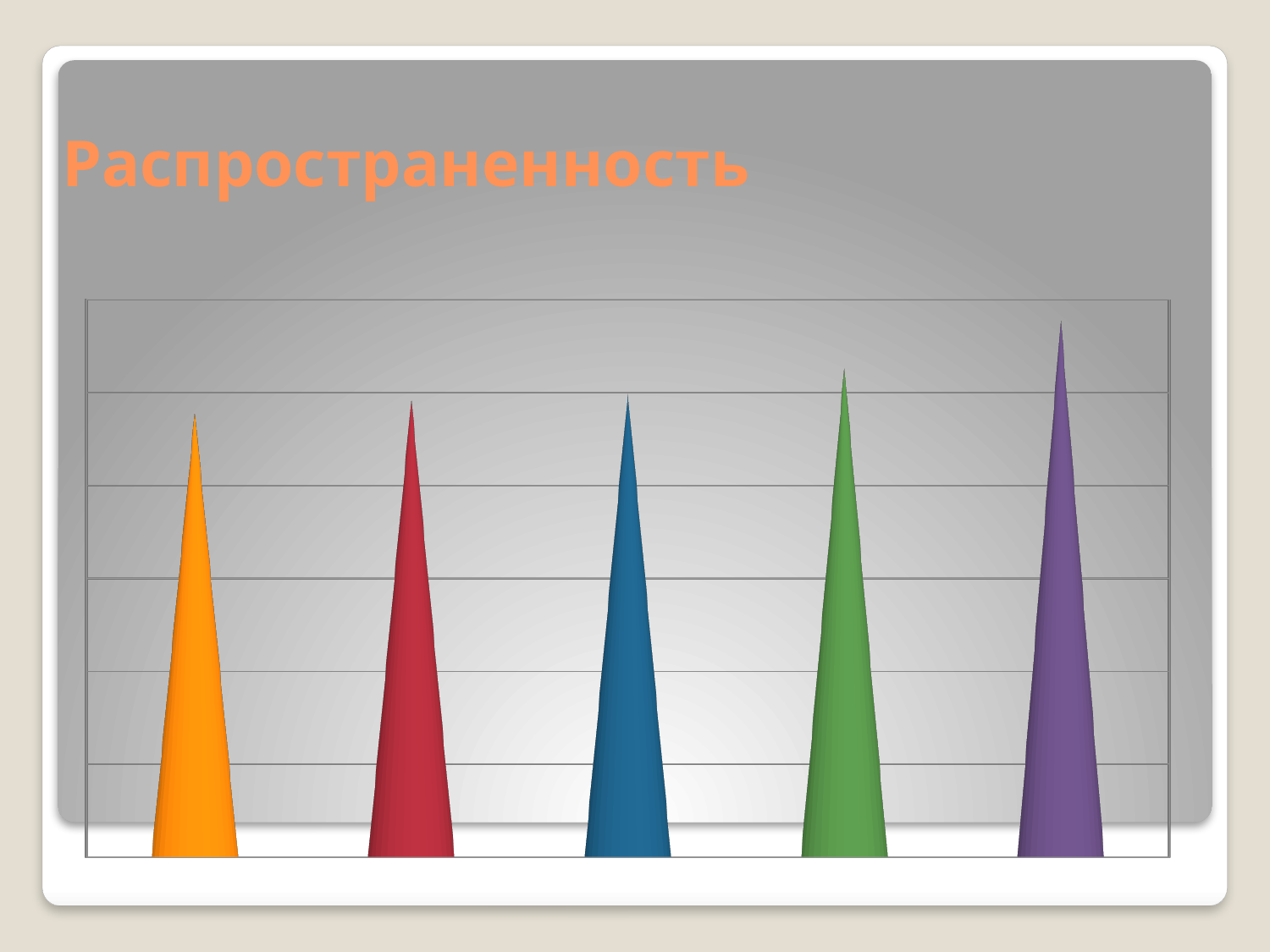
Do the bar heights rise or fall from left to right across the chart? rise Is the green bar taller or shorter than the blue bar? taller How many bars are plotted in the chart? 5 What kind of chart is shown on the slide? bar chart What is the title of the chart on the slide? Распространенность What colour is the tallest bar in the chart? purple Is the leftmost (orange) bar taller or shorter than the rightmost (purple) bar? shorter